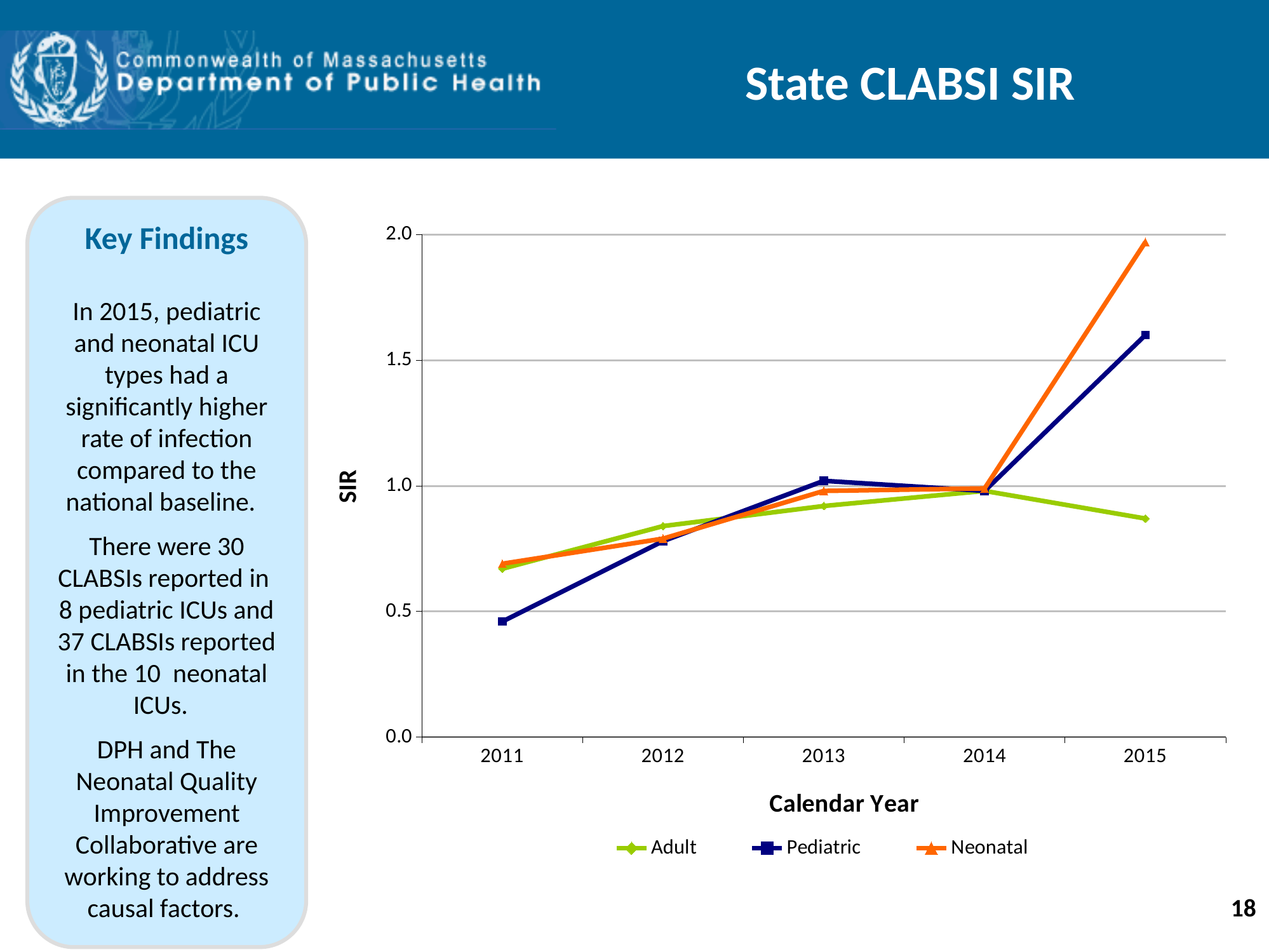
In which year is the Neonatal SIR highest? 2015 Is the Pediatric SIR in 2011 greater or less than 0.5? less In 2011, which is larger: the Adult SIR or the Pediatric SIR? Adult In which year is the Pediatric SIR lowest? 2011 How many calendar years are plotted on the x axis? 5 Does the Adult SIR rise or fall from 2014 to 2015? fall Which series has the highest SIR in 2015? Neonatal Is the Adult SIR in 2015 greater or less than 1.0? less How many series does the legend list? 3 Is the Neonatal SIR in 2015 greater or less than 1.5? greater What is the label on the x axis? Calendar Year What kind of chart is shown on the slide? line chart